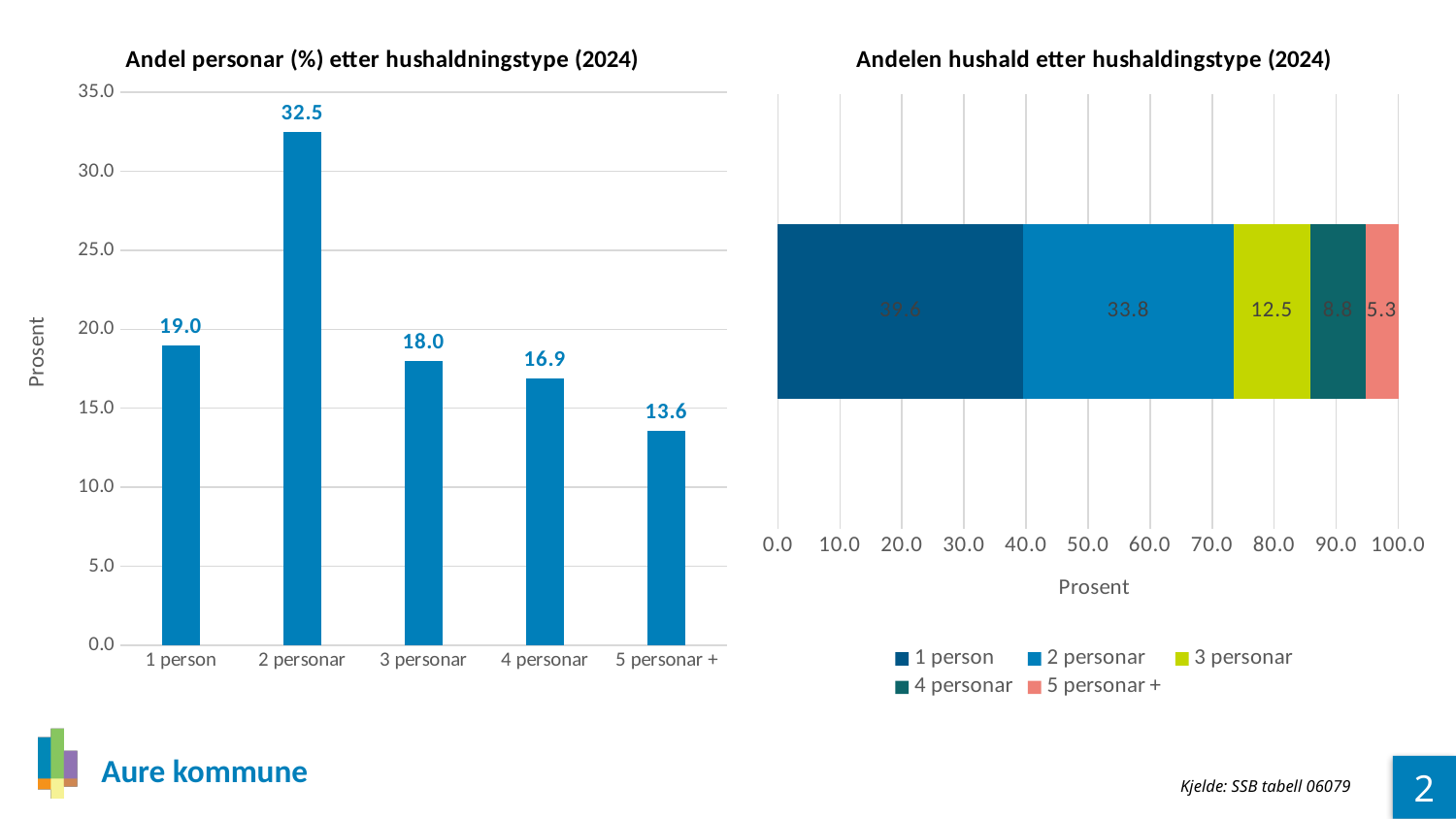
In the chart 'Andel personar (%) etter hushaldningstype (2024)', what is the difference between the values for 2 personar and 1 person? 13.5 What kind of chart is 'Andel personar (%) etter hushaldningstype (2024)'? Bar chart In the chart 'Andelen hushald etter hushaldingstype (2024)', is the value for 1 person greater or less than 30.0? greater How many household types are shown in the chart 'Andel personar (%) etter hushaldningstype (2024)'? 5 In the chart 'Andel personar (%) etter hushaldningstype (2024)', which household type has the lowest value? 5 personar + How many series does the legend of the chart 'Andelen hushald etter hushaldingstype (2024)' list? 5 In the chart 'Andel personar (%) etter hushaldningstype (2024)', which household type has the highest value? 2 personar In the chart 'Andelen hushald etter hushaldingstype (2024)', what is the value for 3 personar? 12.5 In the chart 'Andelen hushald etter hushaldingstype (2024)', what is the value for 2 personar? 33.8 What is the label on the vertical axis of the chart 'Andel personar (%) etter hushaldningstype (2024)'? Prosent In the chart 'Andelen hushald etter hushaldingstype (2024)', which is larger: the value for 4 personar or for 5 personar +? 4 personar In the chart 'Andel personar (%) etter hushaldningstype (2024)', what is the value for 2 personar? 32.5